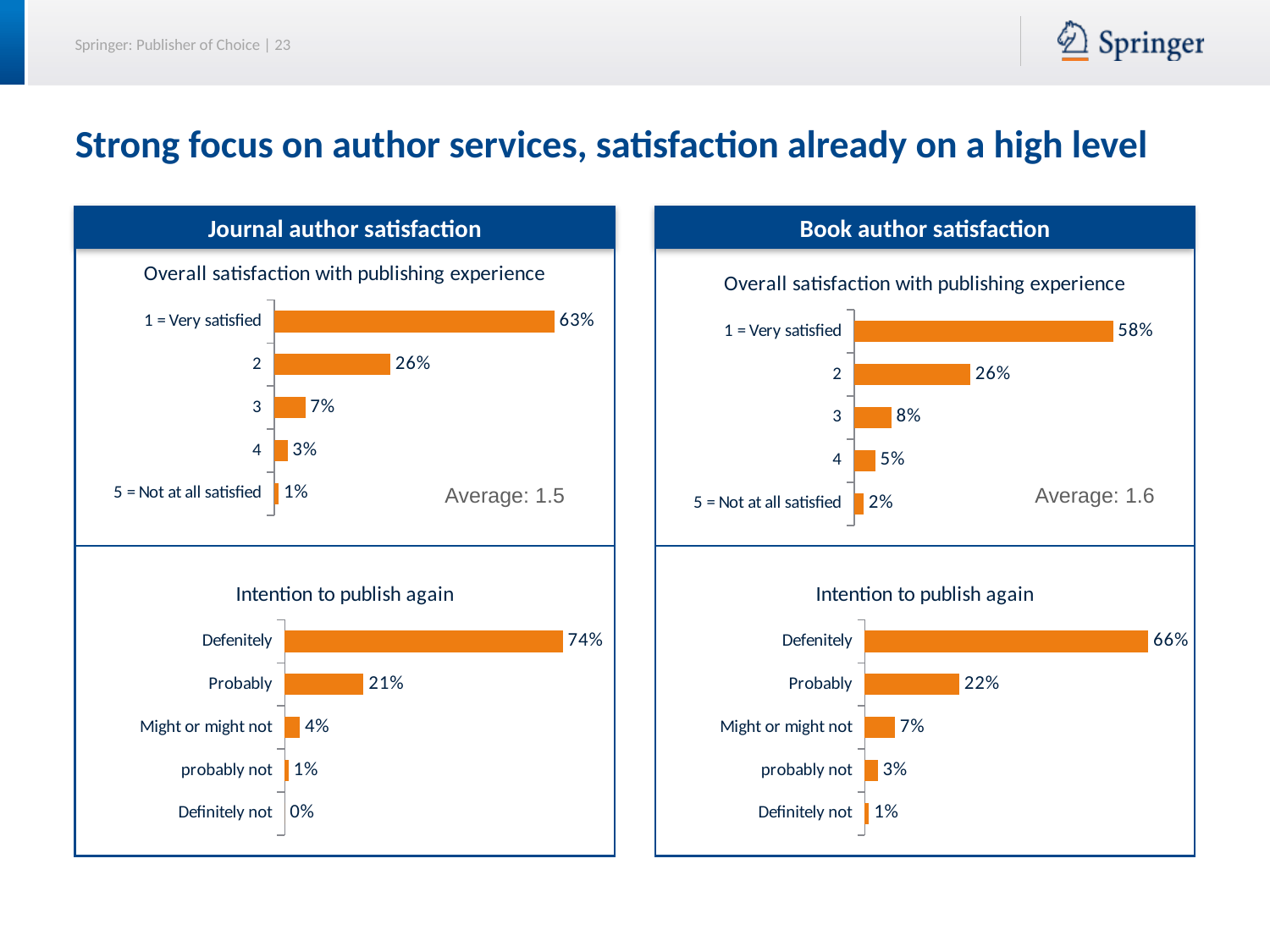
In the Journal author satisfaction 'Intention to publish again' chart, which category has the lowest value? Definitely not In the Journal author satisfaction 'Overall satisfaction with publishing experience' chart, what is the value for '1 = Very satisfied'? 63% In the Book author satisfaction 'Intention to publish again' chart, what is the value for 'Might or might not'? 7% In the Book author satisfaction 'Intention to publish again' chart, what is the difference between the values for 'Defenitely' and 'Probably'? 44% What type of chart is the Journal author satisfaction 'Intention to publish again' chart? Bar chart In the Book author satisfaction 'Overall satisfaction with publishing experience' chart, what is the value for '4'? 5% How many categories are shown in the Book author satisfaction 'Overall satisfaction with publishing experience' chart? 5 In the Journal author satisfaction 'Overall satisfaction with publishing experience' chart, what is the difference between the values for '1 = Very satisfied' and '2'? 37% In the Book author satisfaction 'Intention to publish again' chart, which category has the highest value? Defenitely In the Journal author satisfaction 'Intention to publish again' chart, what is the value for 'Probably'? 21% Which is larger: the 'Defenitely' value in the Journal author satisfaction 'Intention to publish again' chart or the 'Defenitely' value in the Book author satisfaction 'Intention to publish again' chart? Journal author satisfaction (74%) What average is shown in the Book author satisfaction 'Overall satisfaction with publishing experience' chart? 1.6